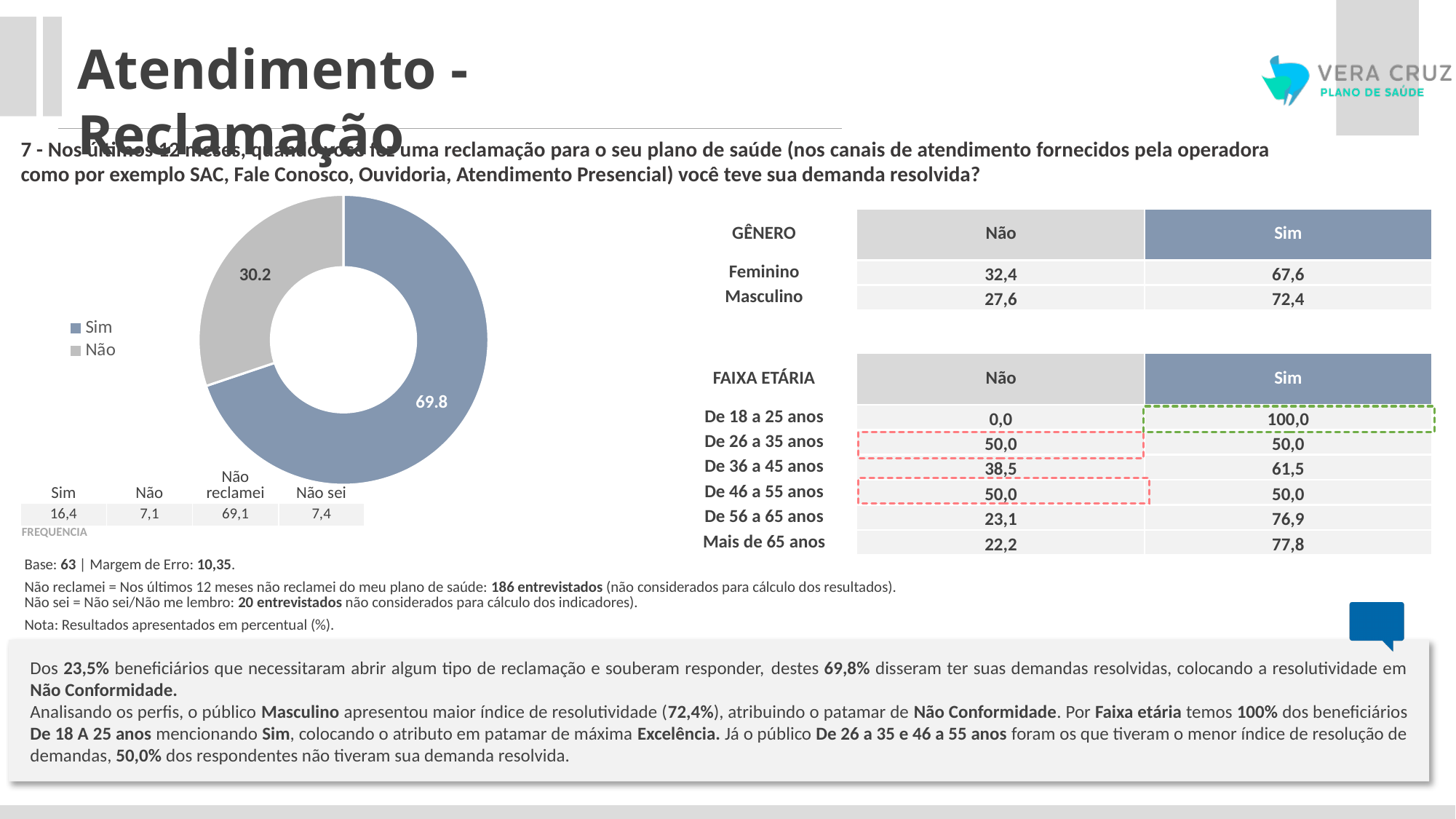
What is the difference between the "Sim" and "Não" values in the donut chart? 39.6 What kind of chart is shown on the left of the slide? Pie (donut) chart In the donut chart, what is the value shown for "Não"? 30.2 What share of the donut chart does the "Não" slice represent? 30.2 How many entries does the legend of the donut chart list? 2 How many categories are shown in the donut chart? 2 What colour is the "Sim" slice in the donut chart? Blue In the donut chart, what is the value shown for "Sim"? 69.8 In the donut chart, which is larger: "Sim" or "Não"? Sim What colour is the "Não" slice in the donut chart? Grey Which category has the largest slice in the donut chart? Sim Which category has the smallest slice in the donut chart? Não